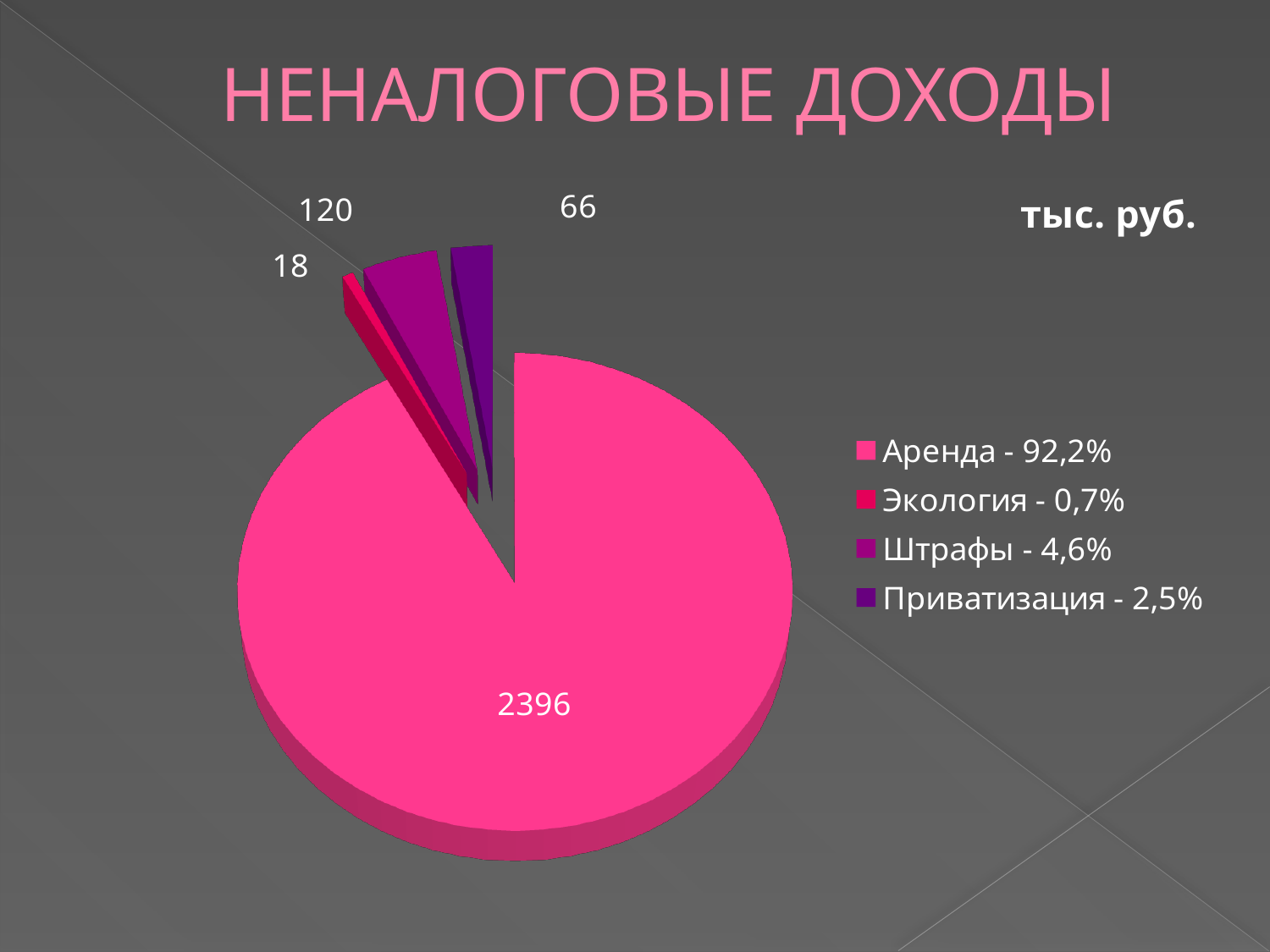
How many categories does the pie chart have? 4 What type of chart is shown on the slide? pie chart Which category has the smallest slice? Экология Which is larger, the value for Приватизация or the value for Экология? Приватизация What is the difference between the values for Штрафы and Приватизация? 54 What share of the pie does Штрафы represent, according to the legend? 4,6% What is the value for Аренда? 2396 Which category has the largest slice? Аренда What is the value for Штрафы? 120 What is the value for Экология? 18 What is the value for Приватизация? 66